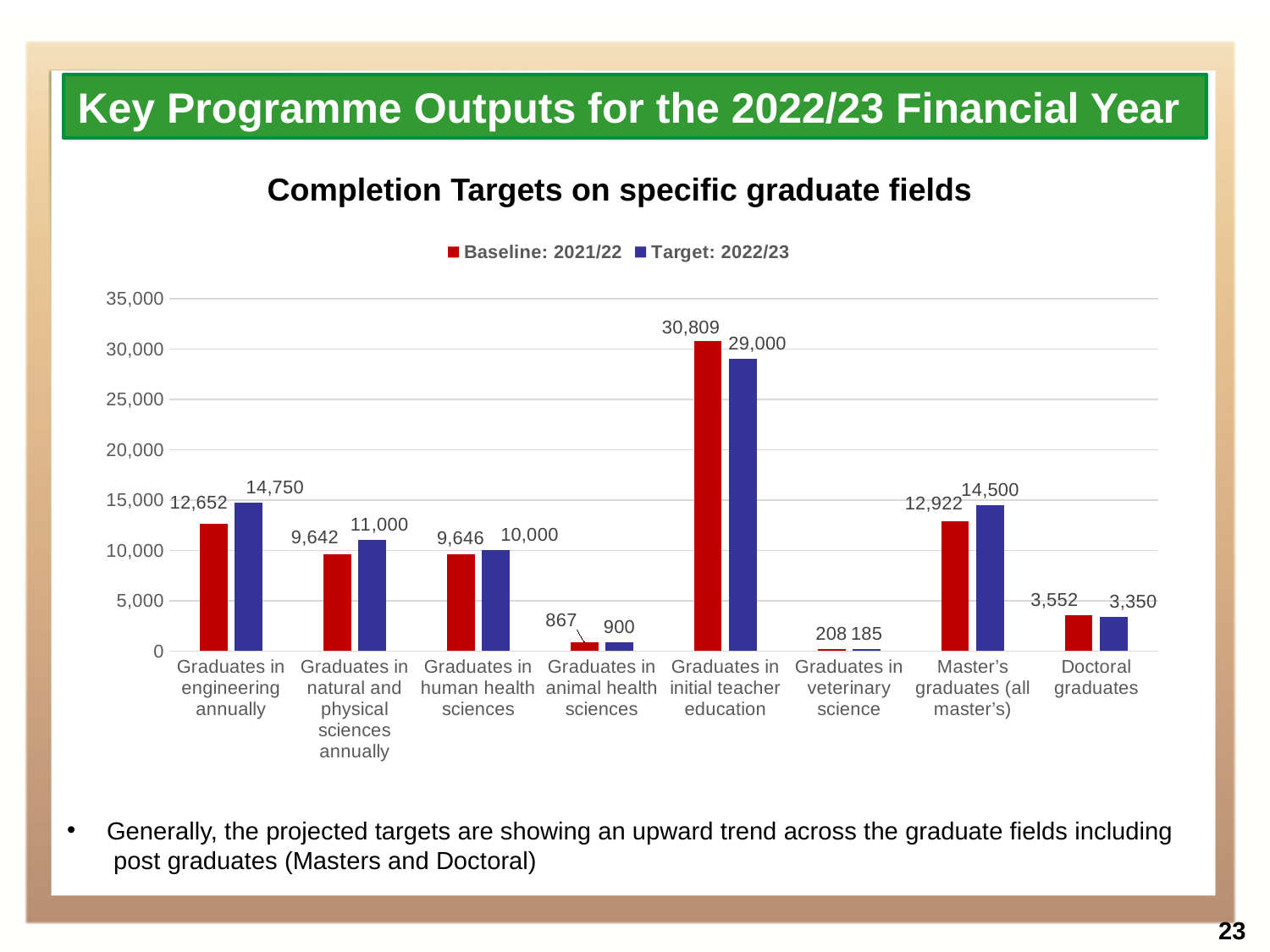
Is the Baseline: 2021/22 value for Graduates in initial teacher education greater or less than 30,000? greater What kind of chart is shown on the slide? bar chart Which category has the highest Baseline: 2021/22 value? Graduates in initial teacher education How many categories are shown on the x axis of the chart? 8 What is the Baseline: 2021/22 value for Graduates in engineering annually? 12,652 What is the Target: 2022/23 value for Master's graduates (all master's)? 14,500 What is the Target: 2022/23 value for Graduates in initial teacher education? 29,000 How many series does the legend list? 2 Which category has the lowest Target: 2022/23 value? Graduates in veterinary science Which is larger for Doctoral graduates, the Baseline: 2021/22 value or the Target: 2022/23 value? Baseline: 2021/22 What is the difference between the Target: 2022/23 and Baseline: 2021/22 values for Graduates in engineering annually? 2,098 What is the title of the chart? Completion Targets on specific graduate fields